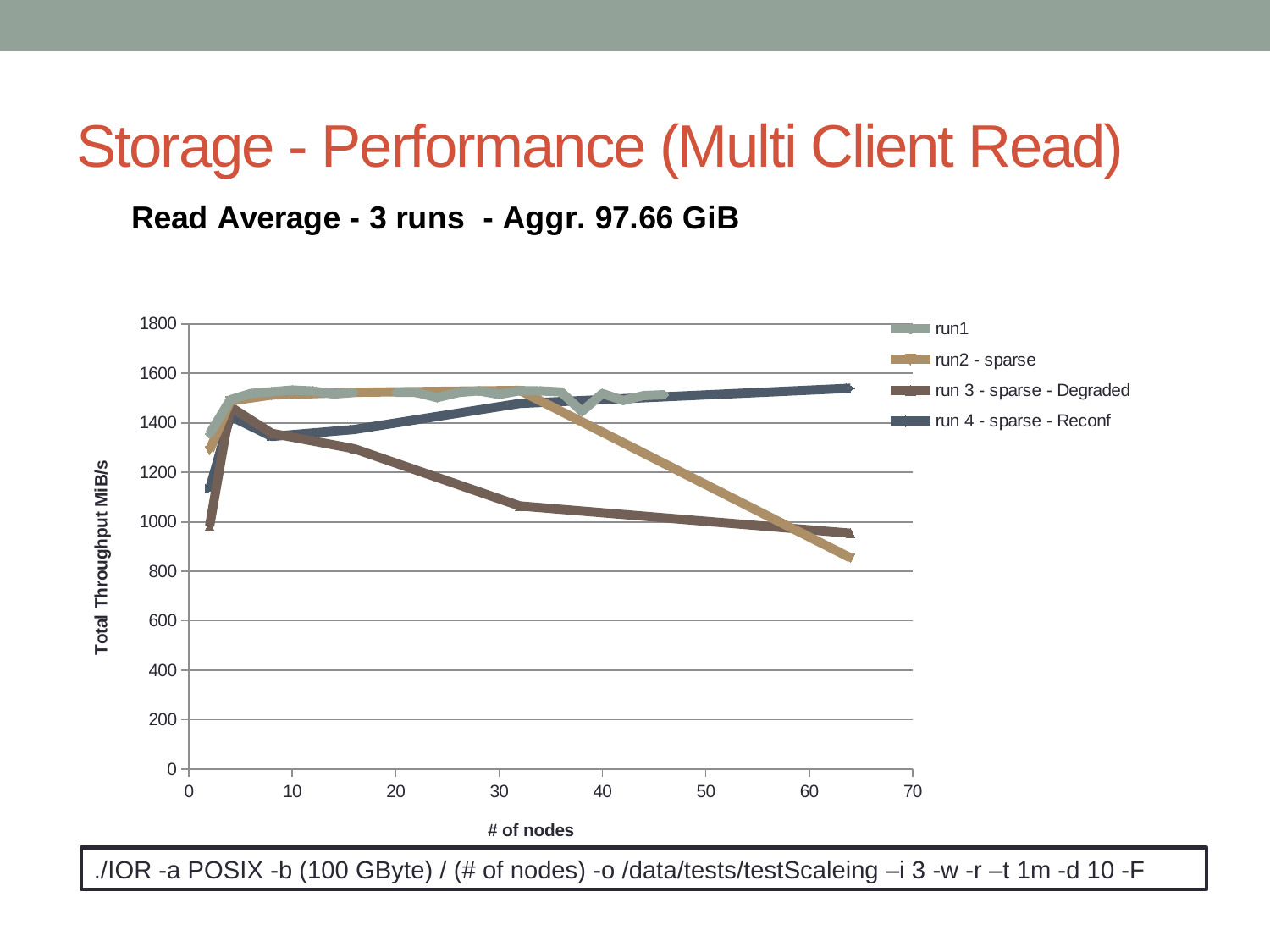
What is the label of the y axis? Total Throughput MiB/s Which series has the lowest value at 64 nodes? run2 - sparse Is the value for run 3 - sparse - Degraded at 32 nodes greater or less than 1200? less Is the value for run1 at 2 nodes greater or less than 1200? greater Which series has the highest value at 64 nodes? run 4 - sparse - Reconf Does the run 3 - sparse - Degraded series rise or fall as the number of nodes increases from 4 to 64? fall How many series does the legend list? 4 Is the value for run 4 - sparse - Reconf at 64 nodes greater or less than 1400? greater What kind of chart is shown on the slide? line chart What is the title of the chart? Read Average - 3 runs - Aggr. 97.66 GiB At 32 nodes, which is larger: run 3 - sparse - Degraded or run 4 - sparse - Reconf? run 4 - sparse - Reconf